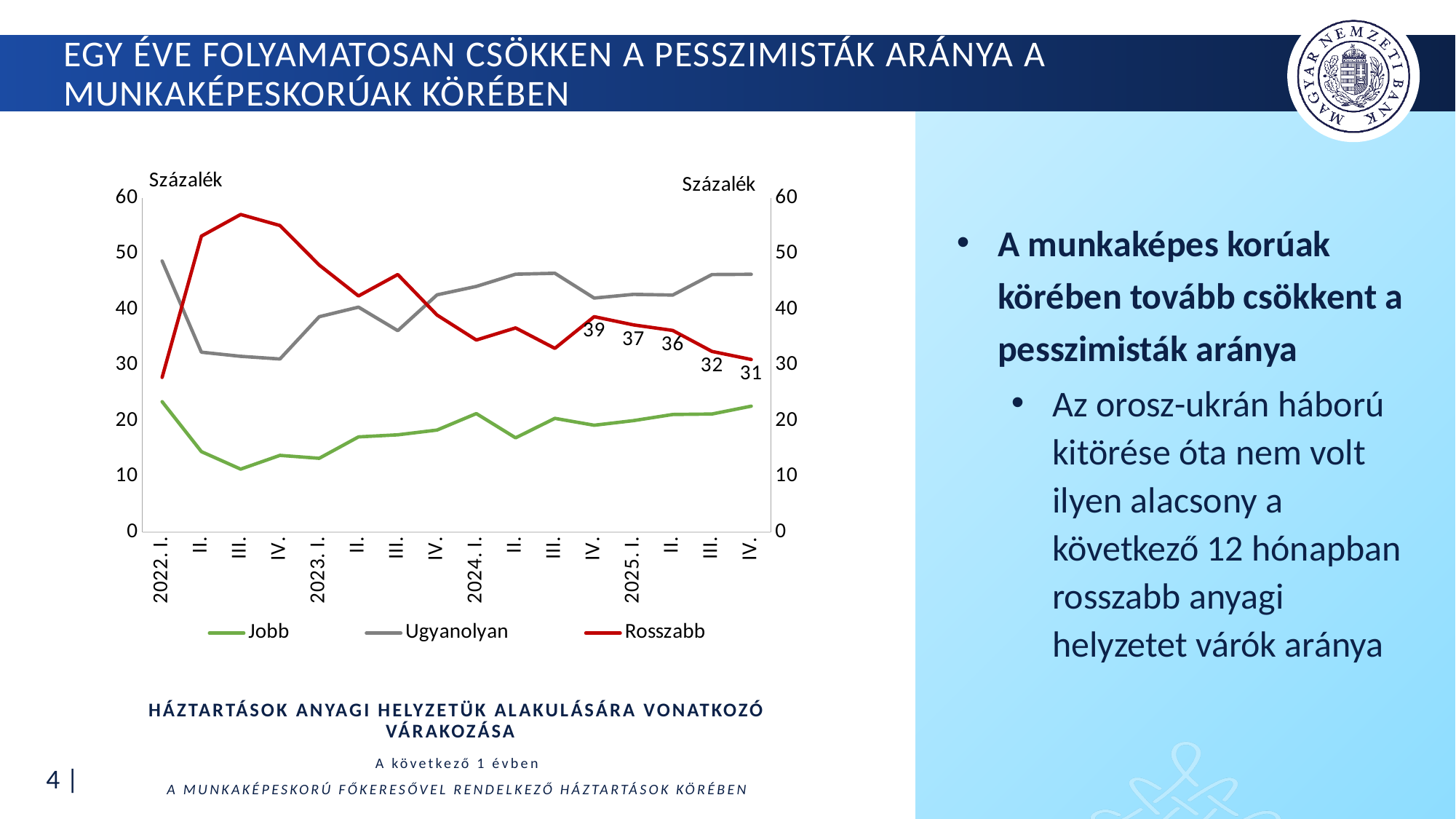
What is the value of the Rosszabb series at 2024. IV.? 39 What kind of chart is shown on the slide? line chart How many quarterly points are plotted along the x axis? 16 What is the value of the Rosszabb series at 2025. IV.? 31 How many series does the legend list? 3 At 2025. IV., which series has the larger value, Ugyanolyan or Rosszabb? Ugyanolyan Does the Rosszabb series rise or fall from 2024. IV. to 2025. IV.? fall Is the value of the Jobb series at 2022. III. greater or less than 20? less What is the value of the Rosszabb series at 2025. II.? 36 By how much did the Rosszabb series fall from 2024. IV. to 2025. IV.? 8 At which quarter does the Rosszabb series reach its highest value? 2022. III. What is the difference between the Rosszabb values at 2025. II. and 2025. III.? 4